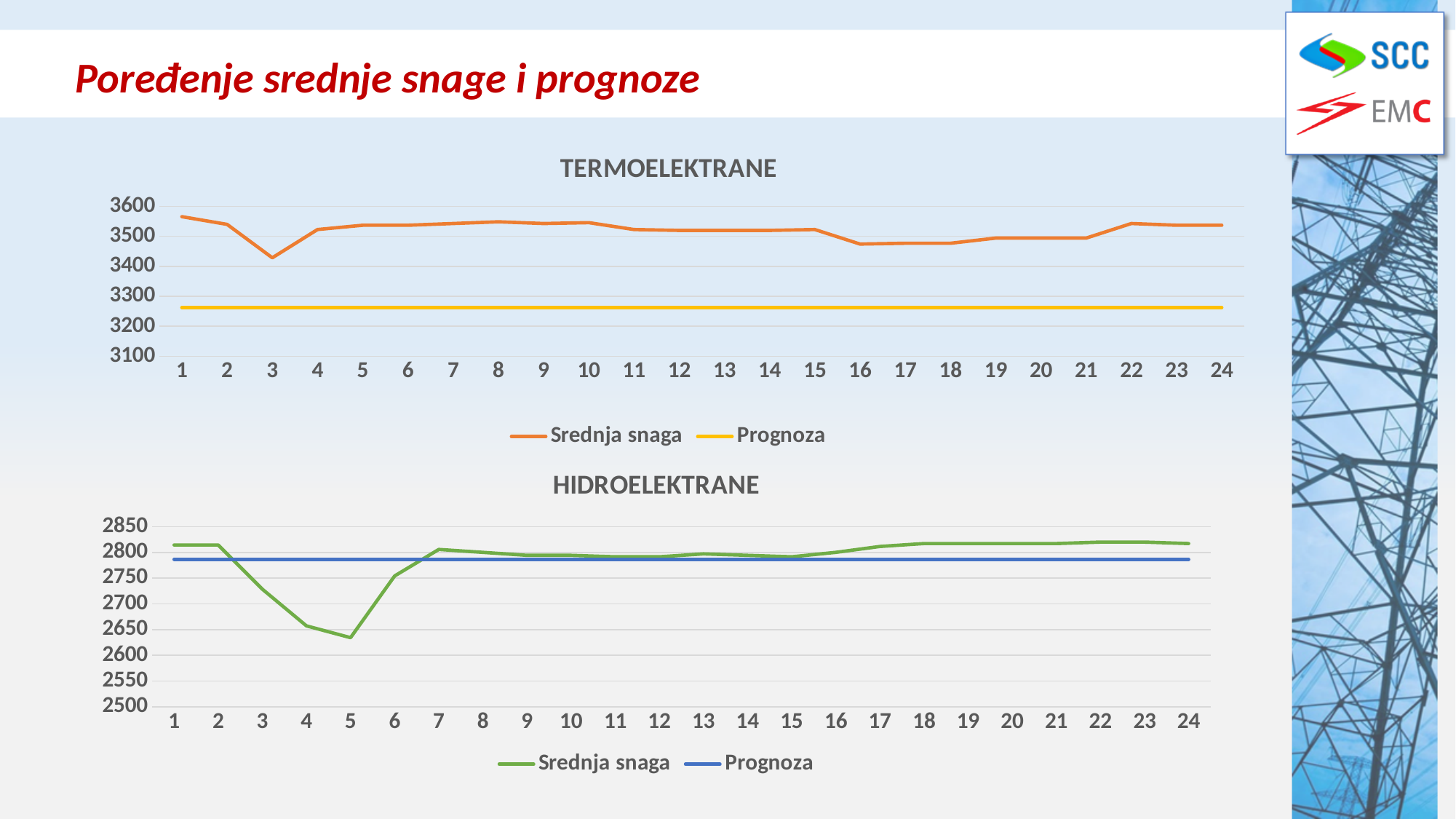
In the TERMOELEKTRANE chart, is the Srednja snaga value at point 3 greater or less than 3500? less In the TERMOELEKTRANE chart, is the Prognoza value greater or less than 3300? less In the TERMOELEKTRANE chart, at which x-axis point is Srednja snaga lowest? 3 In the HIDROELEKTRANE chart, at which x-axis point is Srednja snaga lowest? 5 In the HIDROELEKTRANE chart, which series is higher at point 4, Srednja snaga or Prognoza? Prognoza What kind of chart is the TERMOELEKTRANE chart? line chart In the HIDROELEKTRANE chart, does Srednja snaga rise or fall from point 2 to point 5? fall How many points are plotted along the x axis of the TERMOELEKTRANE chart for each series? 24 How many series does the legend of the HIDROELEKTRANE chart list? 2 In the HIDROELEKTRANE chart, is the Srednja snaga value at point 5 greater or less than 2700? less In the TERMOELEKTRANE chart, which series is higher at point 10, Srednja snaga or Prognoza? Srednja snaga What colour is the Prognoza line in the HIDROELEKTRANE chart? blue